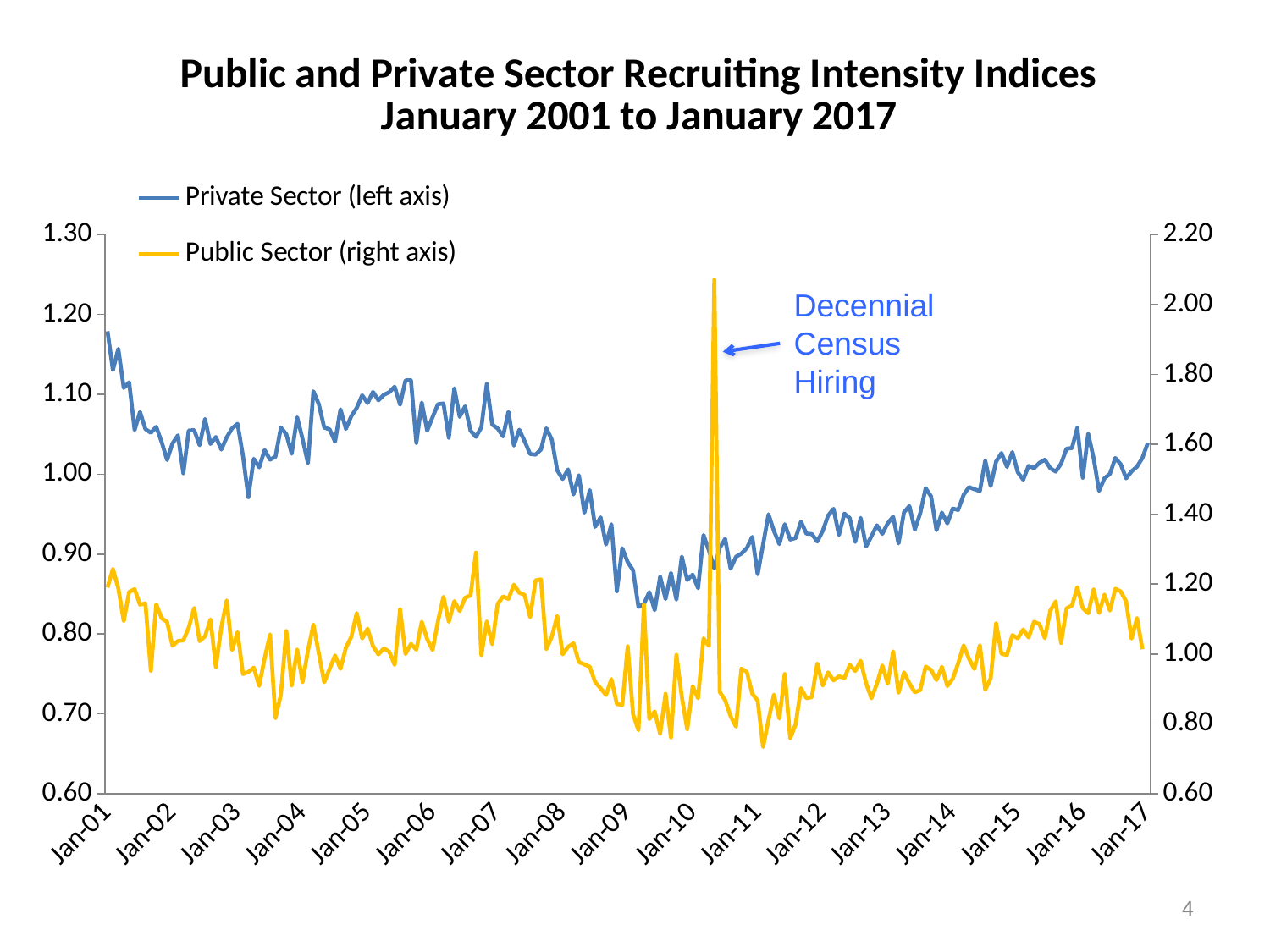
Does the Private Sector series rise or fall between Jan-08 and Jan-09? fall Is the peak value of the Public Sector series (right axis) greater or less than 1.80? greater What kind of chart is shown on the slide? line chart Is the Private Sector value at Jan-01 greater or less than 1.10? greater Which series shows a sharp spike around 2010? Public Sector Does the Private Sector series generally rise or fall between Jan-10 and Jan-17? rise How many year labels are shown on the x axis? 17 According to the legend, which axis is the Public Sector series plotted against? right axis How many series does the legend list? 2 Is the Private Sector value at Jan-09 greater or less than 1.00? less According to the annotation, what event explains the sharp spike in the Public Sector series around 2010? Decennial Census Hiring